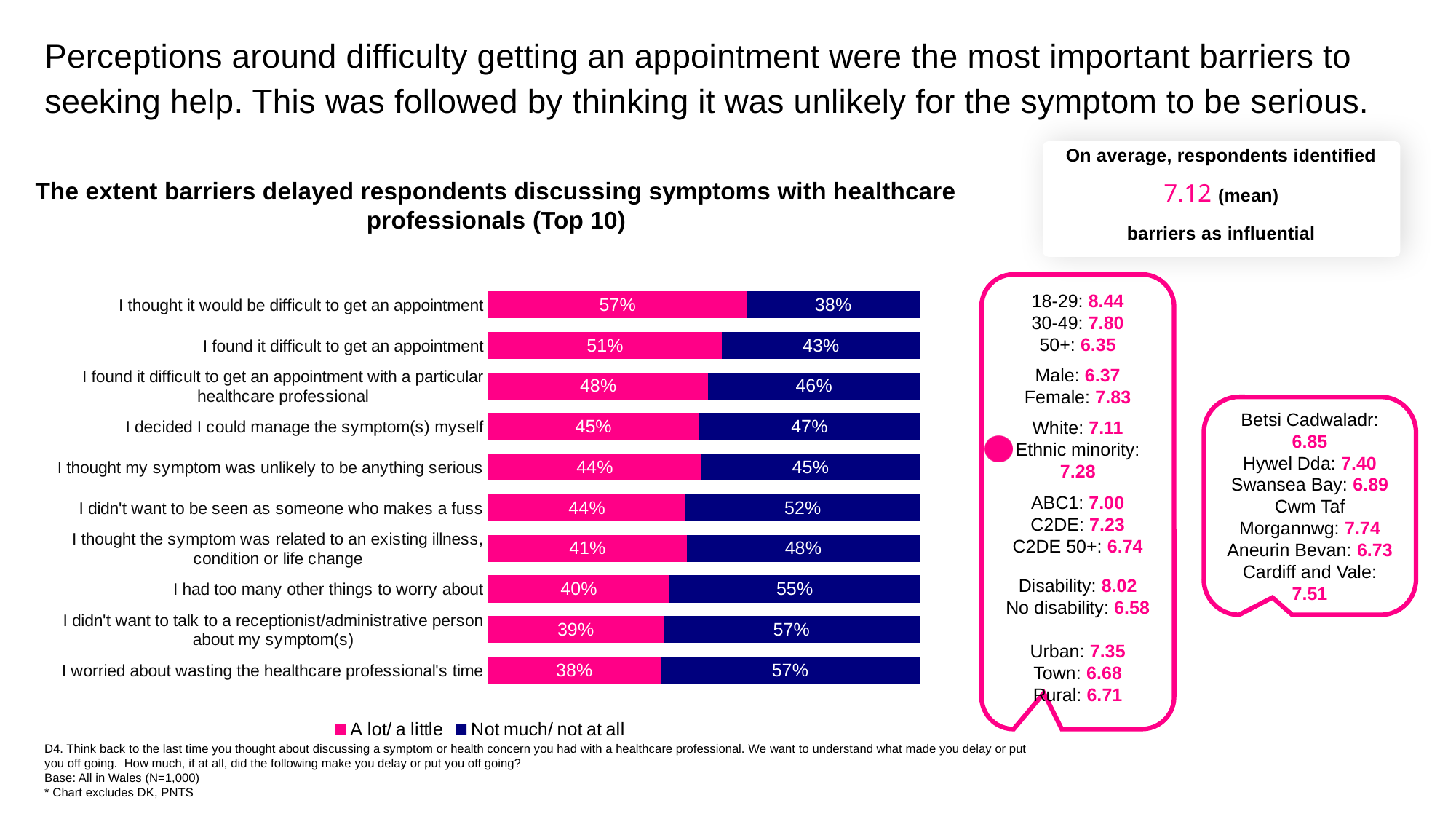
What is the 'A lot/ a little' value for 'I didn't want to talk to a receptionist/administrative person about my symptom(s)'? 39% Which barrier has the highest 'A lot/ a little' percentage? I thought it would be difficult to get an appointment What is the combined total of the two segments for 'I found it difficult to get an appointment'? 94% What is the 'Not much/ not at all' value for 'I had too many other things to worry about'? 55% Which is larger for 'I decided I could manage the symptom(s) myself': the 'A lot/ a little' value or the 'Not much/ not at all' value? Not much/ not at all How many series does the legend list? 2 What is the difference between the 'A lot/ a little' and 'Not much/ not at all' values for 'I didn't want to be seen as someone who makes a fuss'? 8% How many barriers are shown in the chart? 10 Which barrier has the lowest 'A lot/ a little' percentage? I worried about wasting the healthcare professional's time Which colour represents the 'Not much/ not at all' series in the chart? Dark blue What percentage of respondents said 'A lot/ a little' for 'I thought it would be difficult to get an appointment'? 57% What kind of chart is shown on the slide? Stacked bar chart